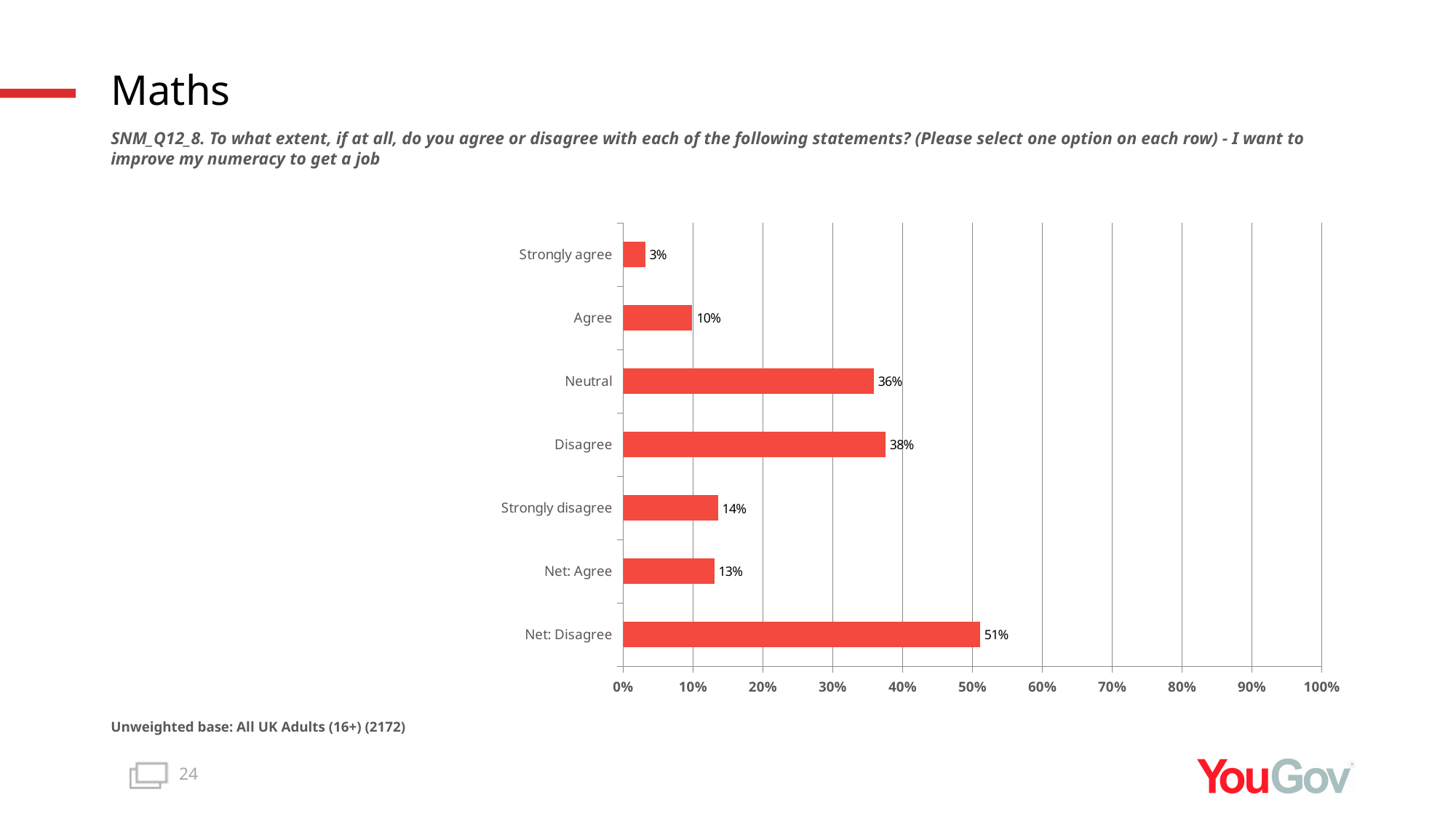
What is the difference between Net: Disagree and Net: Agree? 38% What is the value for Strongly disagree? 14% How many categories are shown on the chart? 7 What is the value for Strongly agree? 3% Which category has the lowest value? Strongly agree What is the value for Neutral? 36% What is the difference between Disagree and Agree? 28% Which is larger, Disagree or Neutral? Disagree Which category has the highest value? Net: Disagree Is the value for Net: Disagree greater or less than 40%? greater What kind of chart is shown on the slide? Bar chart What is the value for Net: Disagree? 51%